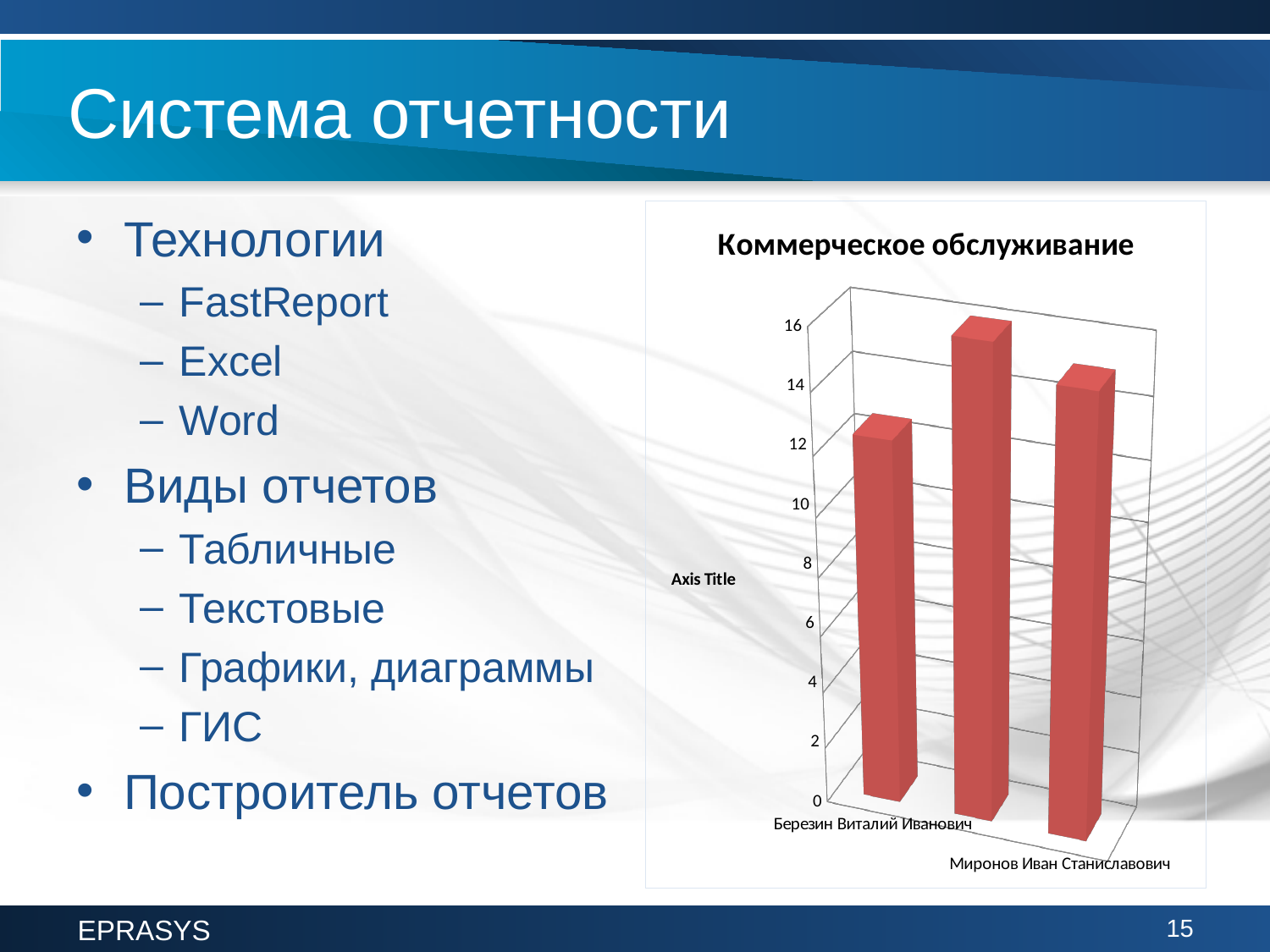
Is the value for Березин Виталий Иванович greater or less than 16? less Is the value for Миронов Иван Станиславович greater or less than 16? less Is the value for Березин Виталий Иванович greater or less than 8? greater What kind of chart is shown on the slide? bar chart Which of the labelled categories has the lowest bar in the chart? Березин Виталий Иванович What is the title of the chart? Коммерческое обслуживание What is the maximum value shown on the vertical axis of the chart? 16 How many bars are plotted in the chart? 3 Which is larger, the value for Березин Виталий Иванович or the value for Миронов Иван Станиславович? Миронов Иван Станиславович